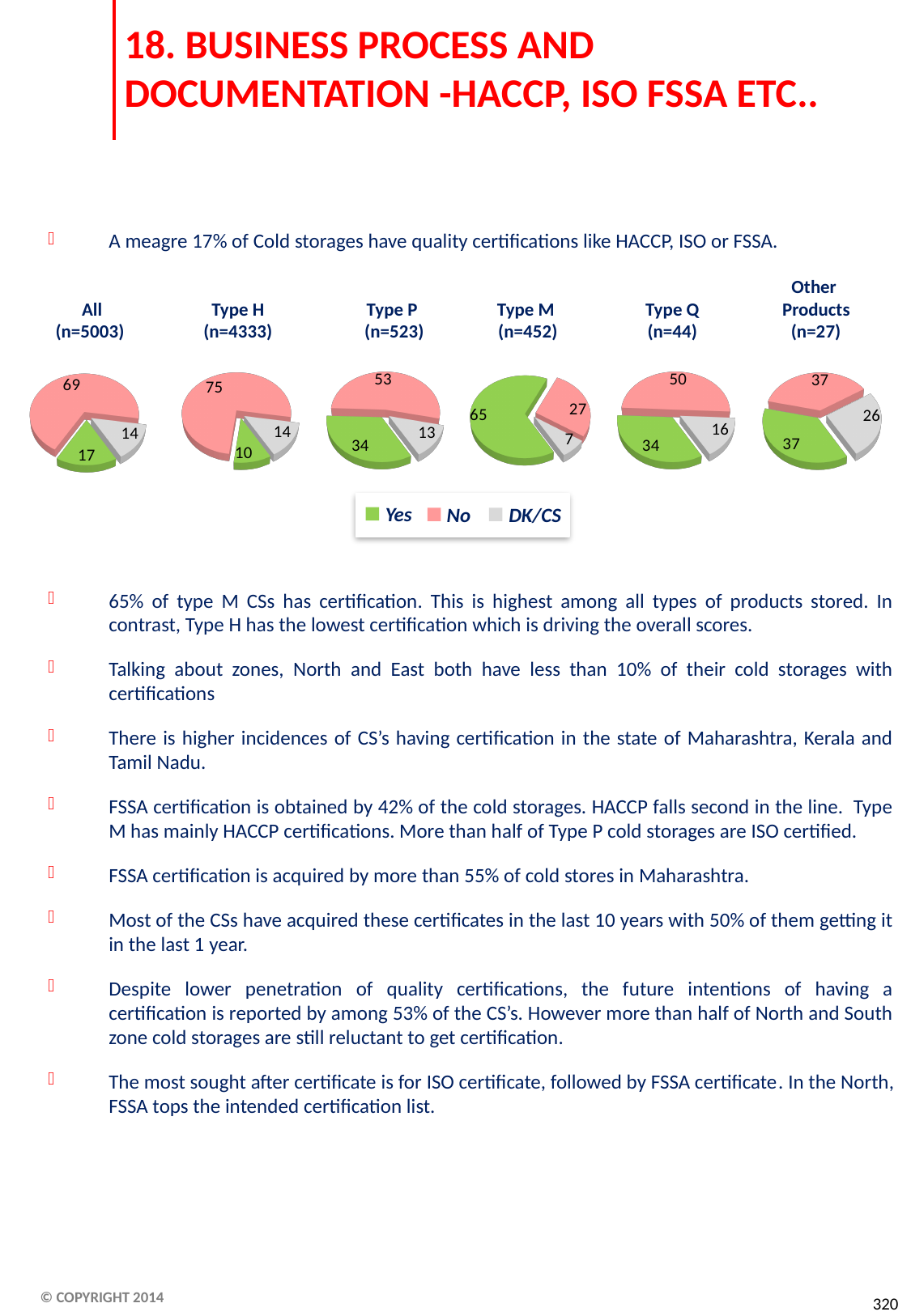
In the 'Type P (n=523)' pie chart, which is larger, the Yes value or the No value? No In the 'Type H (n=4333)' pie chart, what is the difference between the No value and the Yes value? 65 In the 'All (n=5003)' pie chart, what is the value for Yes? 17 How many pie charts are shown on the slide? 6 In the 'Type H (n=4333)' pie chart, what is the value for No? 75 In the 'Type M (n=452)' pie chart, which category has the largest slice? Yes In the 'Type Q (n=44)' pie chart, what is the value for Yes? 34 In the 'Type M (n=452)' pie chart, what is the value for DK/CS? 7 What type of chart is used to show the certification data on this slide? Pie chart In the 'Other Products (n=27)' pie chart, what is the value for DK/CS? 26 In the 'Type P (n=523)' pie chart, which category has the smallest slice? DK/CS How many entries does the shared legend list? 3